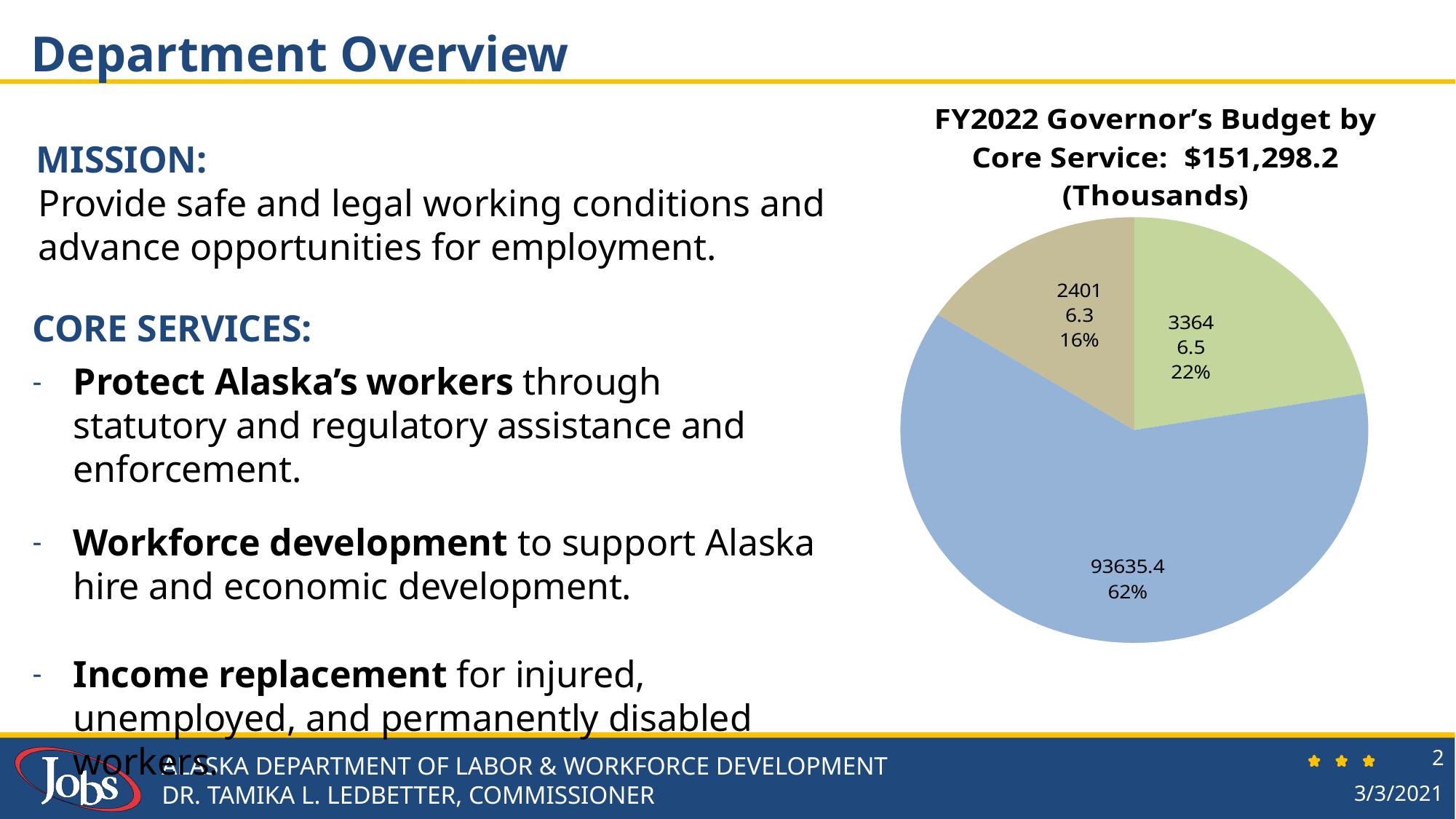
What percentage share is shown on the largest slice of the pie chart? 62% What percentage share is shown on the smallest slice of the pie chart? 16% What is the difference in percentage points between the 62% slice and the 22% slice? 40 percentage points Which slice is larger, the green slice at 22% or the tan slice at 16%? the green slice at 22% What total budget amount is stated in the pie chart title? $151,298.2 (Thousands) What kind of chart is shown on the slide? pie chart What colour is the largest slice of the pie chart? blue Is the share of the blue slice greater or less than 50%? greater How many slices does the pie chart have? 3 What percentage share is shown on the green slice of the pie chart? 22% What is the title of the pie chart? FY2022 Governor's Budget by Core Service: $151,298.2 (Thousands) What value is printed on the blue slice of the pie chart? 93635.4